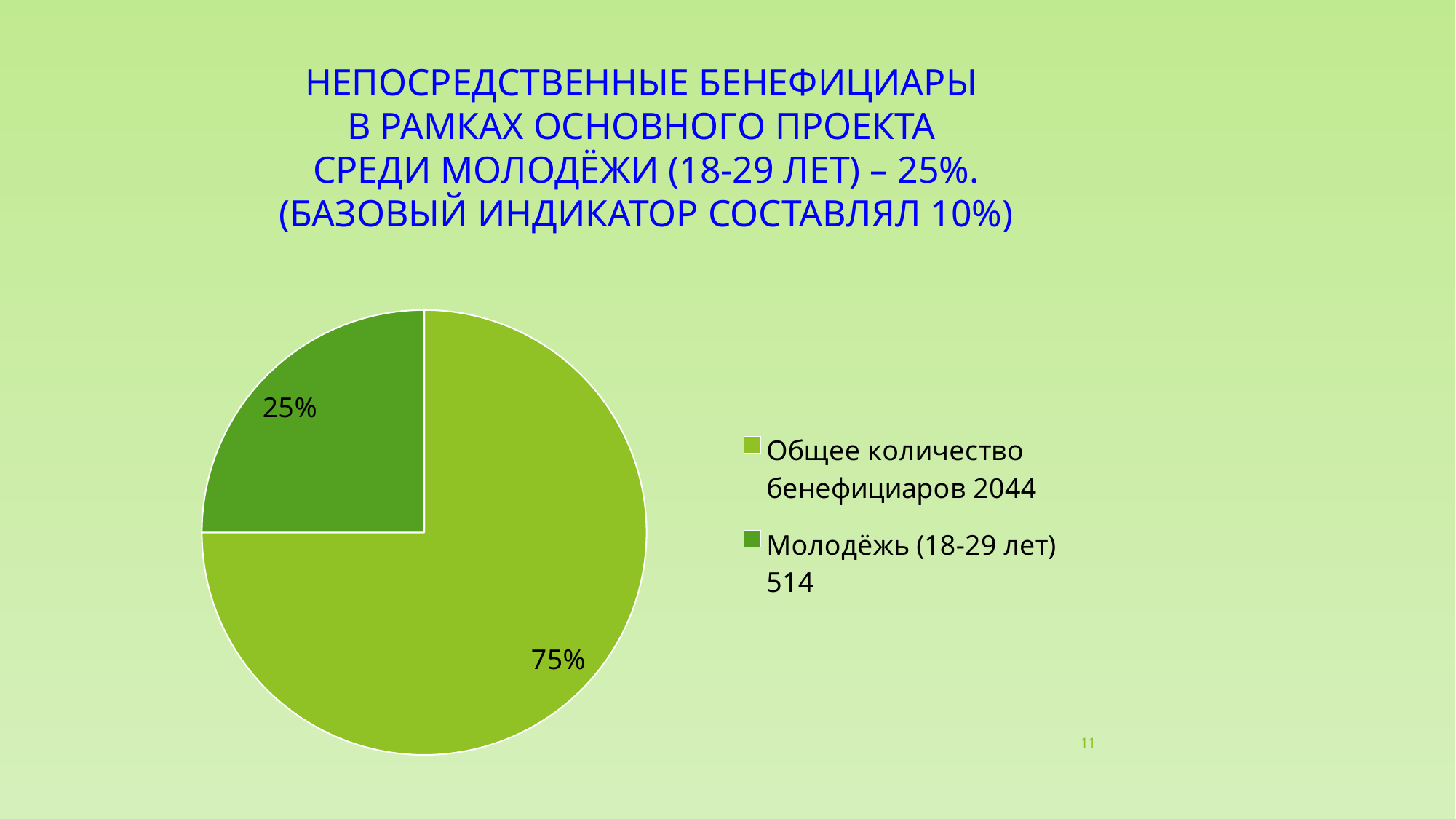
How many entries does the legend of the pie chart list? 2 Which slice of the pie chart is the largest? Общее количество бенефициаров 2044 What share of the pie does the slice for Общее количество бенефициаров 2044 represent? 75% Which legend entry is shown in the darker green colour? Молодёжь (18-29 лет) 514 What is the difference in percentage points between the 75% slice and the 25% slice? 50 percentage points What share of the pie does the slice for Молодёжь (18-29 лет) 514 represent? 25% Which slice of the pie chart is the smallest? Молодёжь (18-29 лет) 514 Which slice is larger: Общее количество бенефициаров 2044 or Молодёжь (18-29 лет) 514? Общее количество бенефициаров 2044 What number is given in the legend next to Общее количество бенефициаров? 2044 How many slices does the pie chart have? 2 Is the share for Молодёжь (18-29 лет) greater or less than 50%? less What kind of chart is shown on the slide? Pie chart